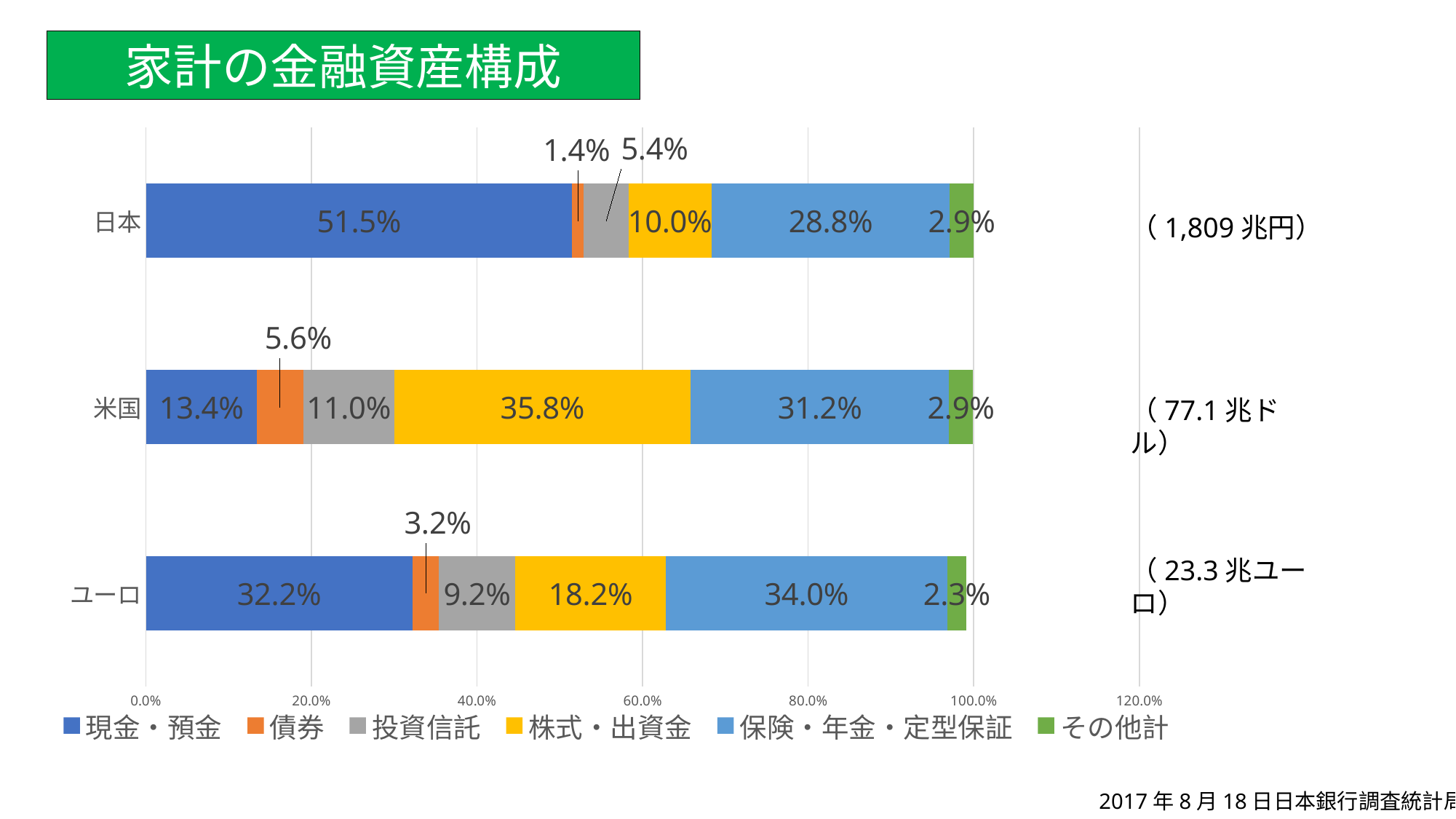
What is the share of 現金・預金 for 日本? 51.5% What is the share of 保険・年金・定型保証 for ユーロ? 34.0% What is the share of 債券 for 日本? 1.4% Which region has the lowest share of 株式・出資金? 日本 What is the difference between the 株式・出資金 share for 米国 and for ユーロ? 17.6% Which is larger: the 投資信託 share for 米国 or for ユーロ? 米国 How many categories (regions) are plotted on the chart? 3 What is the share of 株式・出資金 for 米国? 35.8% Which region has the highest share of 現金・預金? 日本 How many series does the legend list? 6 What kind of chart is shown on the slide? stacked bar chart What is the title of the chart? 家計の金融資産構成